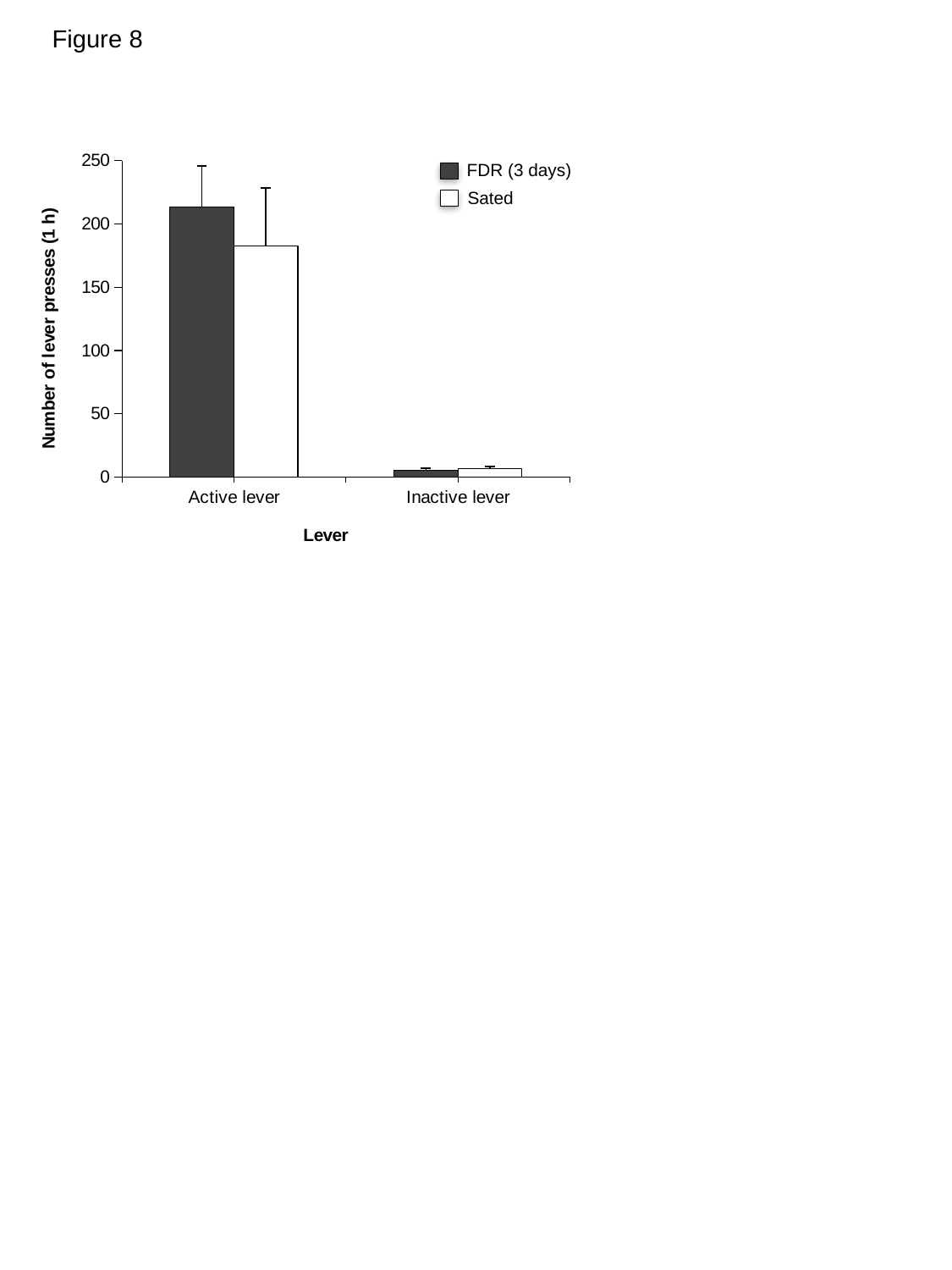
Which series is shown with the dark filled bars? FDR (3 days) Which lever category has the highest FDR (3 days) value? Active lever How many lever categories are shown on the x axis? 2 How many series does the legend list? 2 Is the FDR (3 days) value for Active lever greater or less than 200? greater Is the Sated value for Active lever greater or less than 200? less For Active lever, which series has the larger value, FDR (3 days) or Sated? FDR (3 days) Is the FDR (3 days) value for Inactive lever greater or less than 50? less Which lever category has the lowest values for both series? Inactive lever What kind of chart is shown on the slide? bar chart What is the label of the y axis? Number of lever presses (1 h)